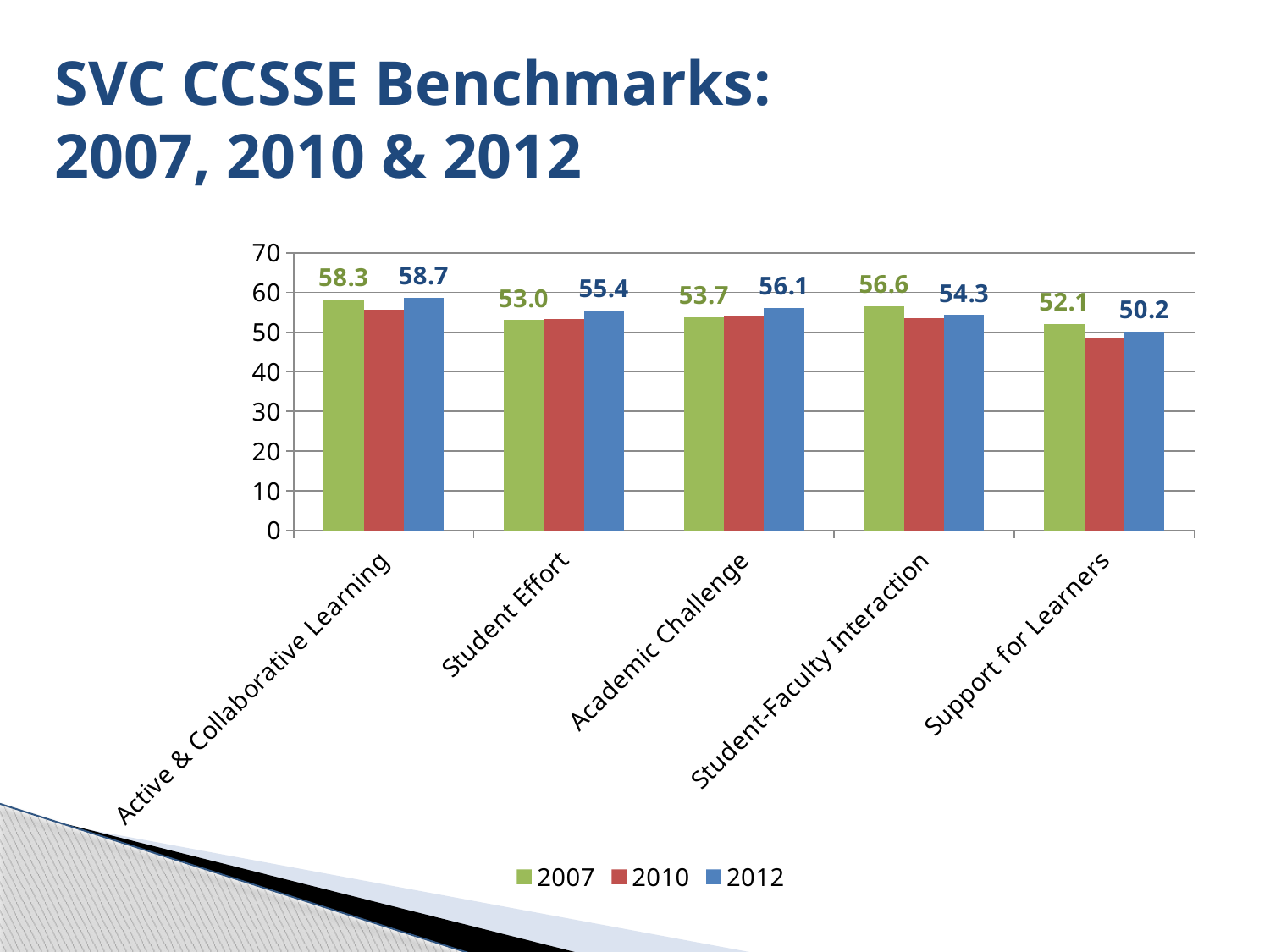
How many benchmark categories are shown on the x axis? 5 How much higher is the 2012 value than the 2007 value for Student Effort? 2.4 Which benchmark has the lowest 2007 value? Support for Learners For Student-Faculty Interaction, which year has the larger value, 2007 or 2012? 2007 Is the 2010 value for Active & Collaborative Learning greater or less than 50? greater What is the 2012 value for Student Effort? 55.4 How many series does the legend list? 3 What kind of chart is shown on the slide? bar chart Is the 2010 value for Support for Learners greater or less than 50? less What is the 2007 value for Active & Collaborative Learning? 58.3 Which benchmark has the highest 2012 value? Active & Collaborative Learning What is the 2012 value for Support for Learners? 50.2